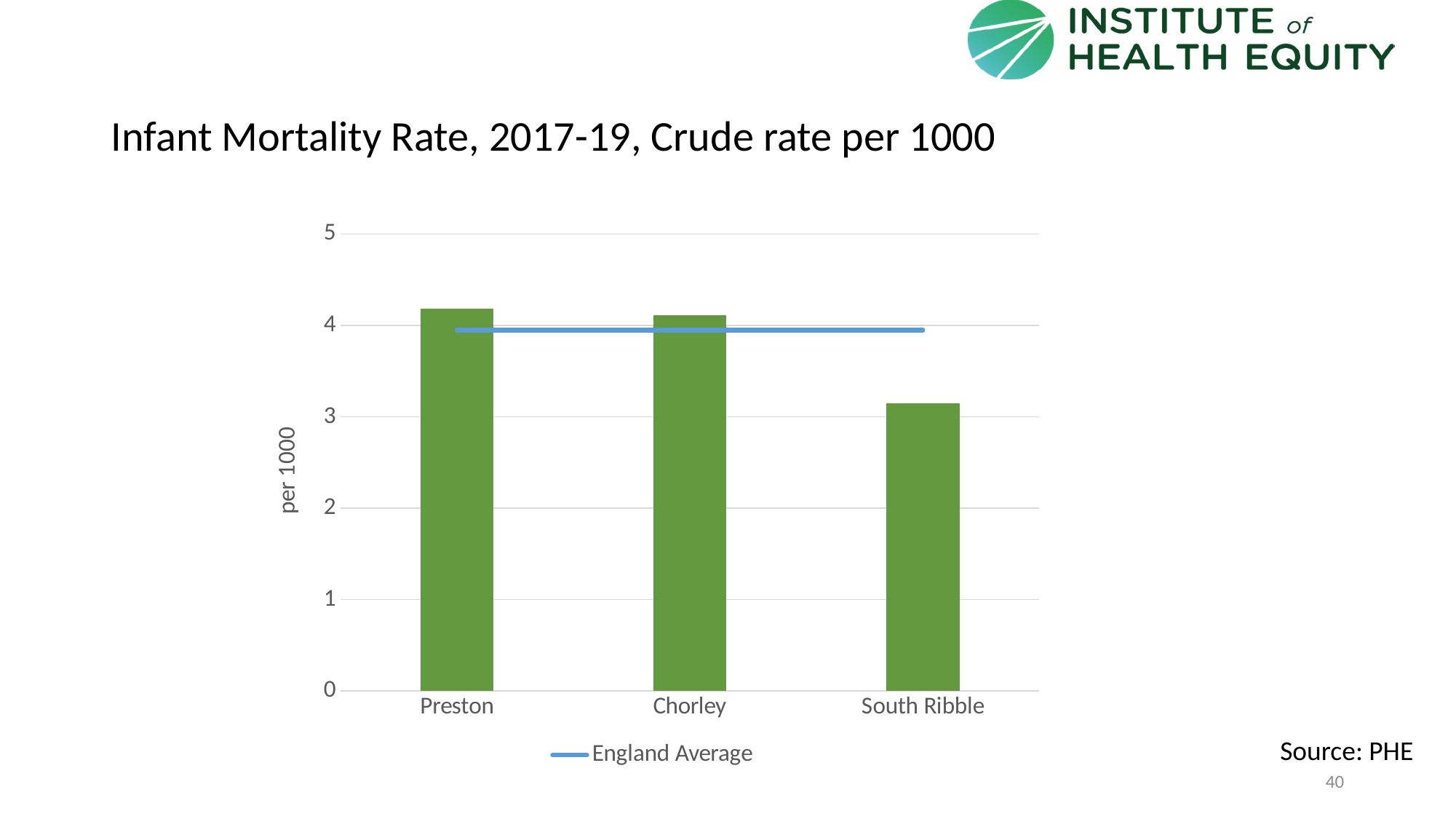
Is the value for South Ribble greater or less than 4? less What does the blue horizontal line represent, according to the legend? England Average How many entries does the legend list? 1 How many areas (categories) are plotted on the x axis? 3 Which is larger, the value for Preston or the value for South Ribble? Preston Is the value for South Ribble greater or less than 3? greater What is the label on the y axis? per 1000 Which is larger, the value for Chorley or the value for South Ribble? Chorley Is the value for Preston greater or less than 4? greater What kind of chart is shown on the slide? combination bar and line chart Which area has the lowest infant mortality rate? South Ribble